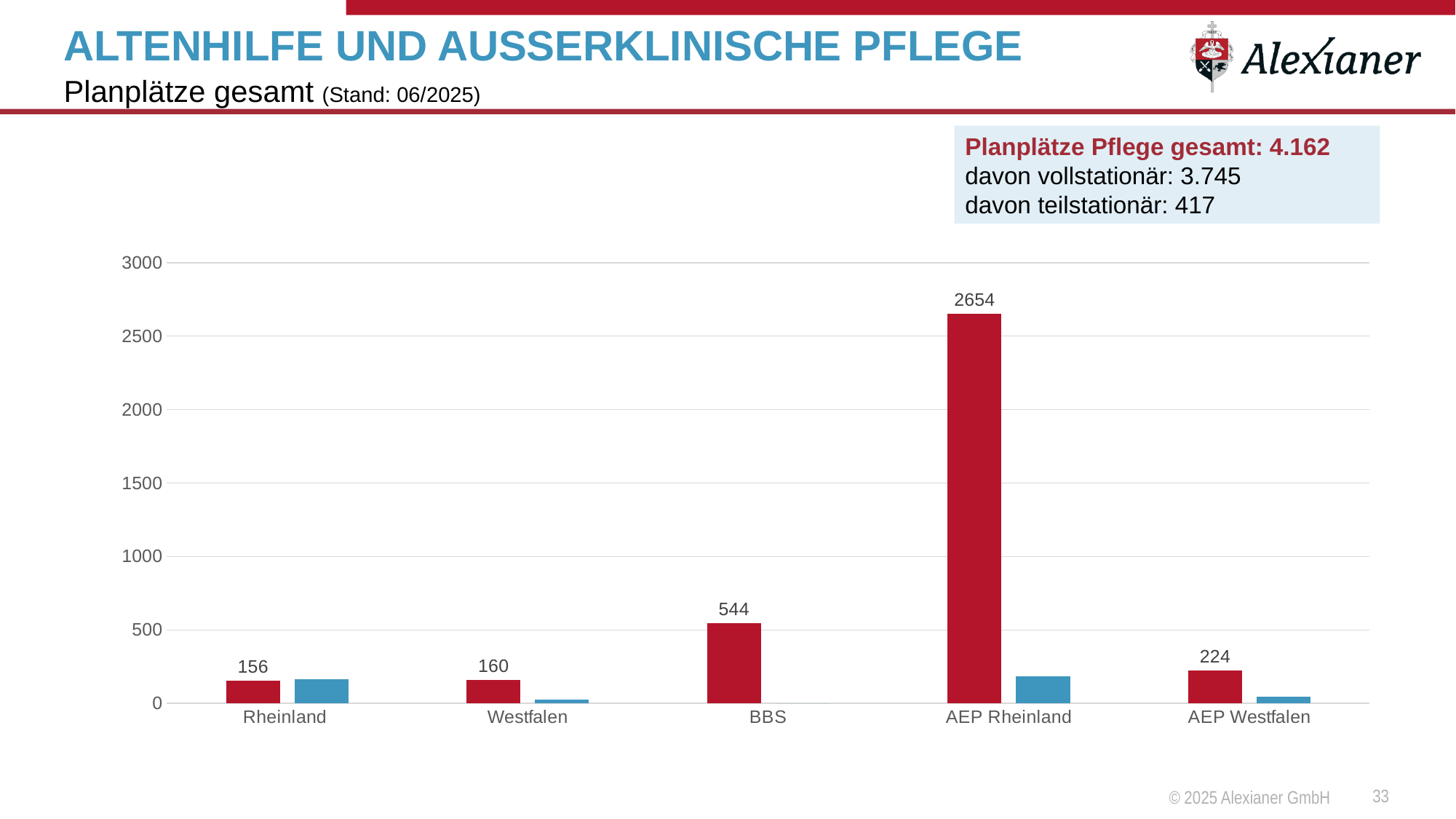
What type of chart is shown on the slide? bar chart What is the value of the red bar for AEP Rheinland? 2654 What is the value of the red bar for Rheinland? 156 How many categories are shown on the x axis of the chart? 5 What is the difference between the red bar values for AEP Rheinland and BBS? 2110 Which red bar is larger, AEP Westfalen or Westfalen? AEP Westfalen Which category has the highest red bar? AEP Rheinland Is the value of the blue bar for AEP Rheinland greater or less than 500? less Which category has the lowest labelled red bar? Rheinland According to the text box on the slide, what is the total number of Planplätze Pflege gesamt? 4.162 What is the value of the red bar for AEP Westfalen? 224 What is the value of the red bar for BBS? 544